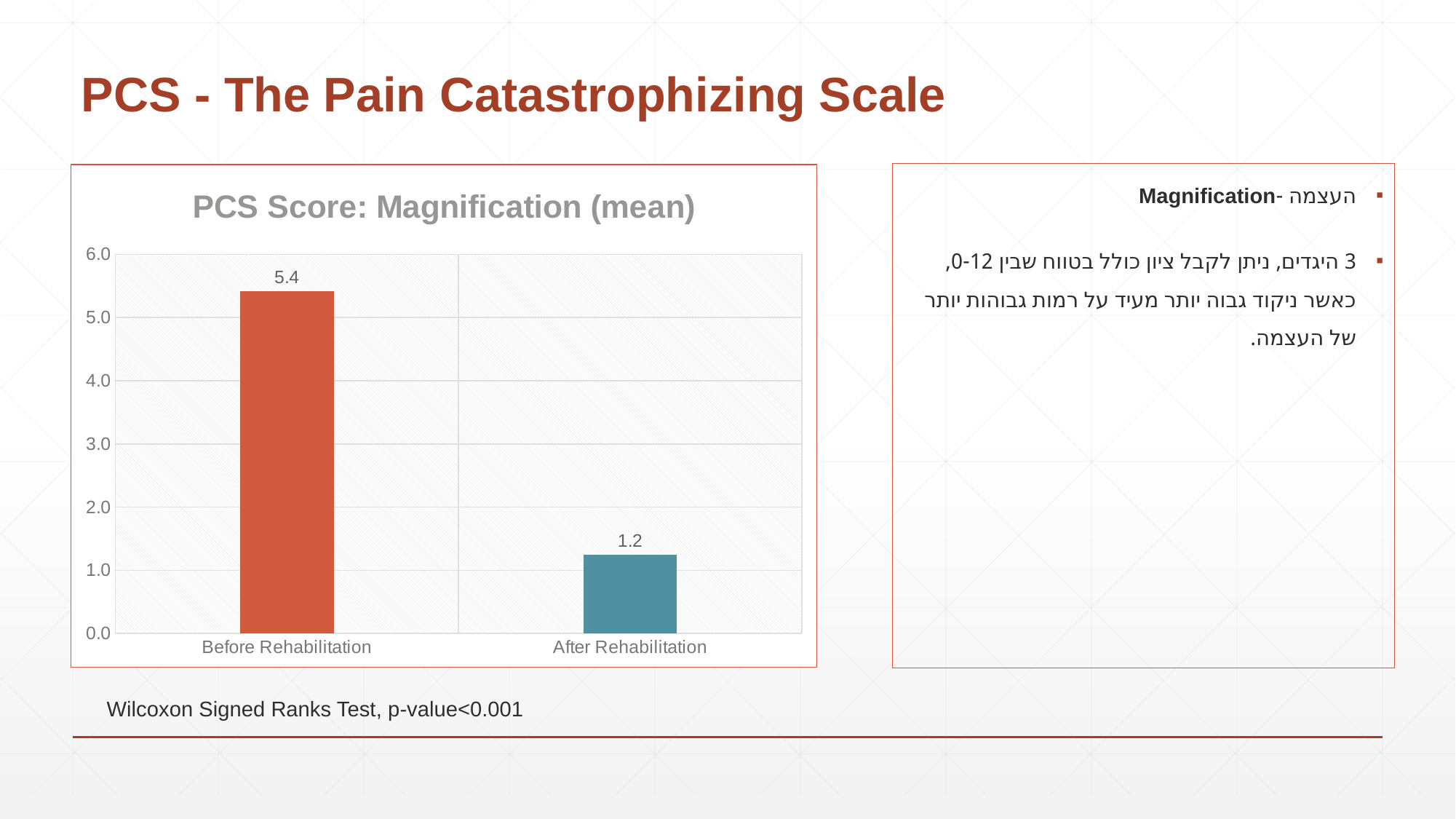
What kind of chart is shown on the slide? Bar chart What is the mean PCS Magnification score before rehabilitation? 5.4 Which is larger, the value for Before Rehabilitation or After Rehabilitation? Before Rehabilitation Is the value for After Rehabilitation greater or less than 2.0? less Which category has the highest value in the chart? Before Rehabilitation Do the values rise or fall from Before Rehabilitation to After Rehabilitation? Fall Which category has the lowest value in the chart? After Rehabilitation What is the difference between the Before Rehabilitation and After Rehabilitation values? 4.2 Is the value for Before Rehabilitation greater or less than 5.0? greater How many categories are shown on the x axis of the chart? 2 What is the mean PCS Magnification score after rehabilitation? 1.2 What is the title of the chart? PCS Score: Magnification (mean)